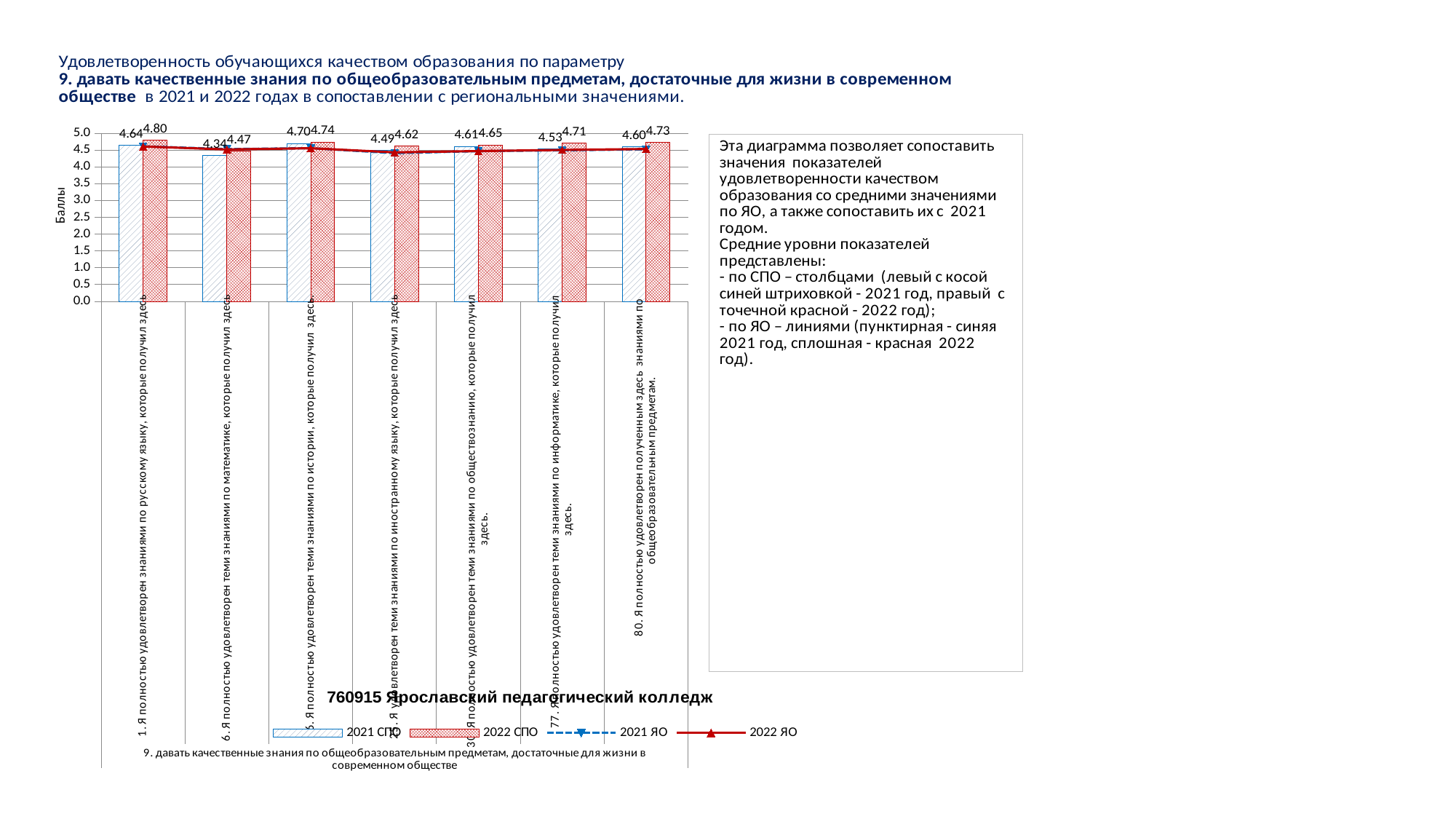
How many series does the chart legend list? 4 Which is larger for the category about social studies (обществознанию): the 2021 СПО value or the 2022 СПО value? 2022 СПО How many categories are shown on the x axis of the chart? 7 What is the 2021 СПО value for the category about knowledge of the Russian language (русскому языку)? 4.64 What is the label of the vertical axis of the chart? Баллы What is the 2022 СПО value for the category about knowledge of informatics (информатике)? 4.71 Which category has the highest 2022 СПО value? 1. Я полностью удовлетворен знаниями по русскому языку, которые получил здесь Which category has the lowest 2021 СПО value? 6. Я полностью удовлетворен теми знаниями по математике, которые получил здесь What is the difference between the 2022 СПО and 2021 СПО values for the category about the foreign language (иностранному языку)? 0.13 What is the 2021 СПО value for the category about knowledge of history (истории)? 4.70 Is the 2021 СПО value for the category about mathematics (математике) greater or less than 4.5? less What is the 2022 СПО value for the category about knowledge of mathematics (математике)? 4.47